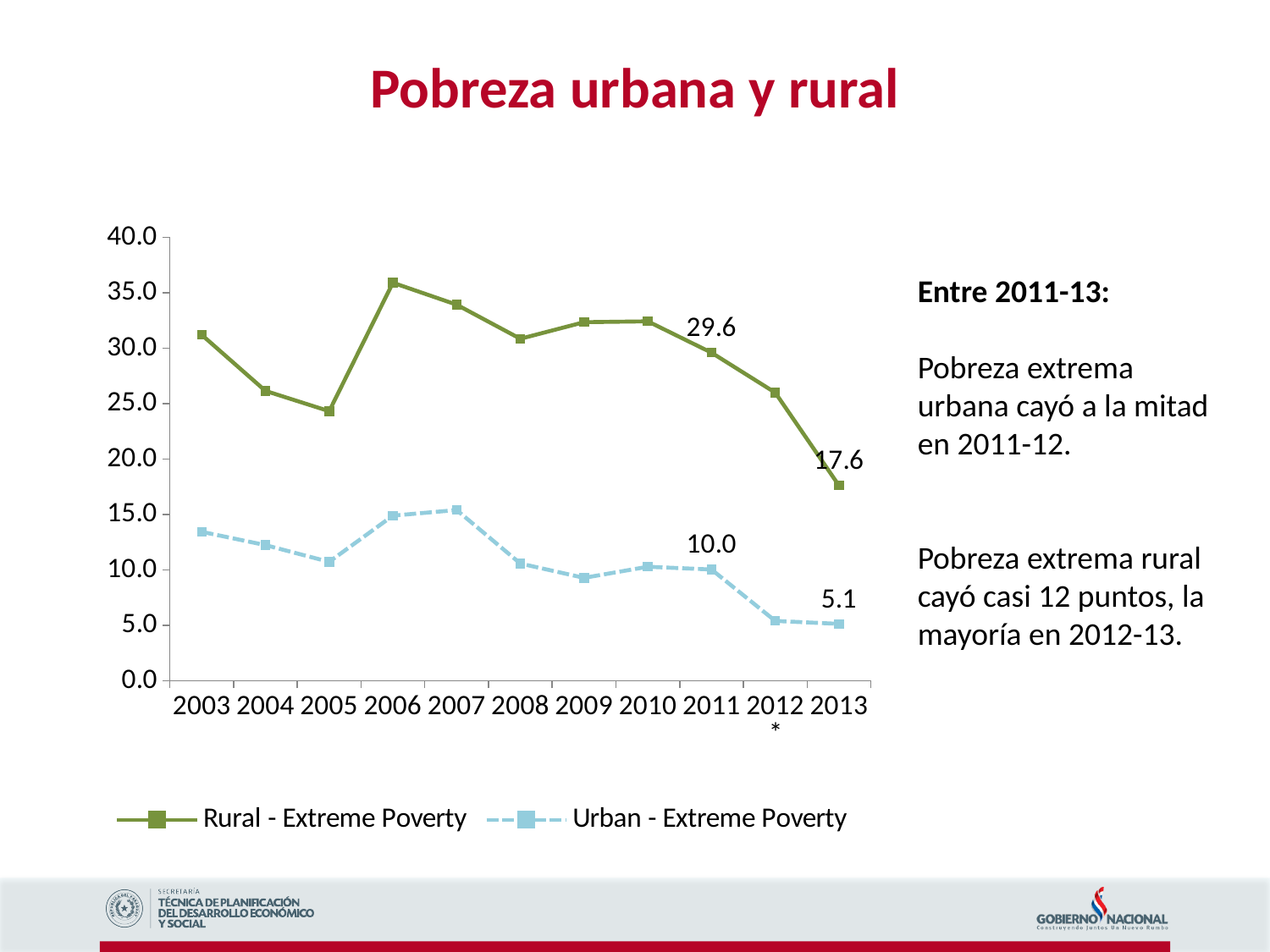
By how much did Rural - Extreme Poverty fall between 2011 and 2013? 12.0 What is the value for Urban - Extreme Poverty in 2013? 5.1 By how much did Urban - Extreme Poverty fall between 2011 and 2013? 4.9 How many series does the legend list? 2 In which year does Rural - Extreme Poverty reach its highest value? 2006 What is the value for Rural - Extreme Poverty in 2011? 29.6 In 2013, which series has the higher value, Rural - Extreme Poverty or Urban - Extreme Poverty? Rural - Extreme Poverty Is the value for Rural - Extreme Poverty in 2006 greater or less than 35.0? greater What is the value for Urban - Extreme Poverty in 2011? 10.0 What is the value for Rural - Extreme Poverty in 2013? 17.6 What kind of chart is shown on the slide? Line chart In which year does Urban - Extreme Poverty reach its lowest value? 2013